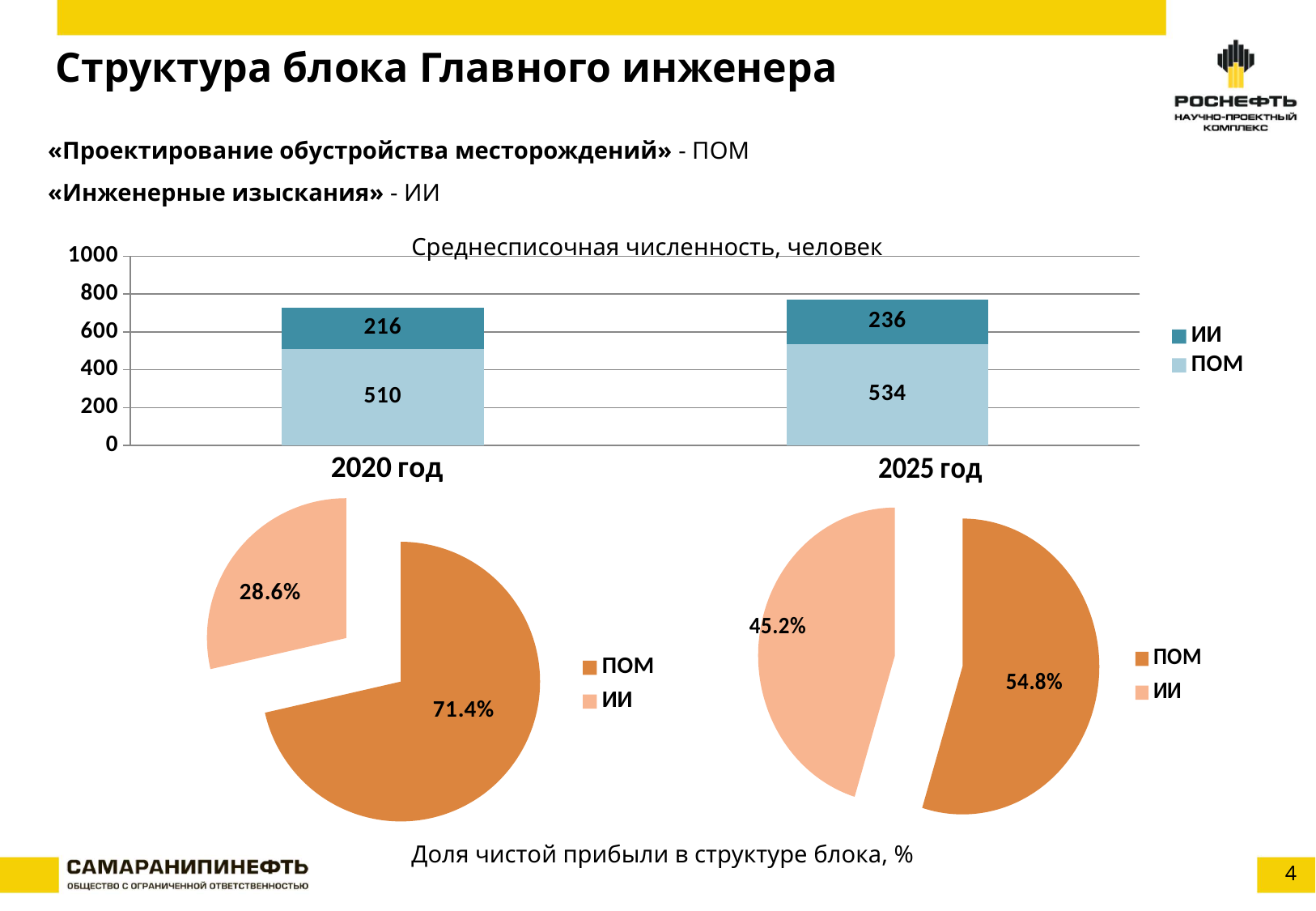
In the bar chart 'Среднесписочная численность, человек', what is the total of the stacked bar for 2025 год? 770 In the bar chart 'Среднесписочная численность, человек', what is the value for ИИ in 2025 год? 236 In the bar chart 'Среднесписочная численность, человек', what is the total of the stacked bar for 2020 год? 726 In the bar chart 'Среднесписочная численность, человек', what is the difference between the ПОМ values for 2025 год and 2020 год? 24 In the bar chart 'Среднесписочная численность, человек', what is the value for ПОМ in 2020 год? 510 In the right pie chart (under 2025 год), what share does ИИ have? 45.2% What kind of chart is 'Среднесписочная численность, человек'? Stacked bar chart In the left pie chart (under 2020 год), what share does ПОМ have? 71.4% In the right pie chart (under 2025 год), which slice is larger: ПОМ or ИИ? ПОМ How many series does the legend of the bar chart 'Среднесписочная численность, человек' list? 2 In the bar chart 'Среднесписочная численность, человек', which is larger: ИИ in 2020 год or ИИ in 2025 год? ИИ in 2025 год What is the caption printed below the two pie charts? Доля чистой прибыли в структуре блока, %